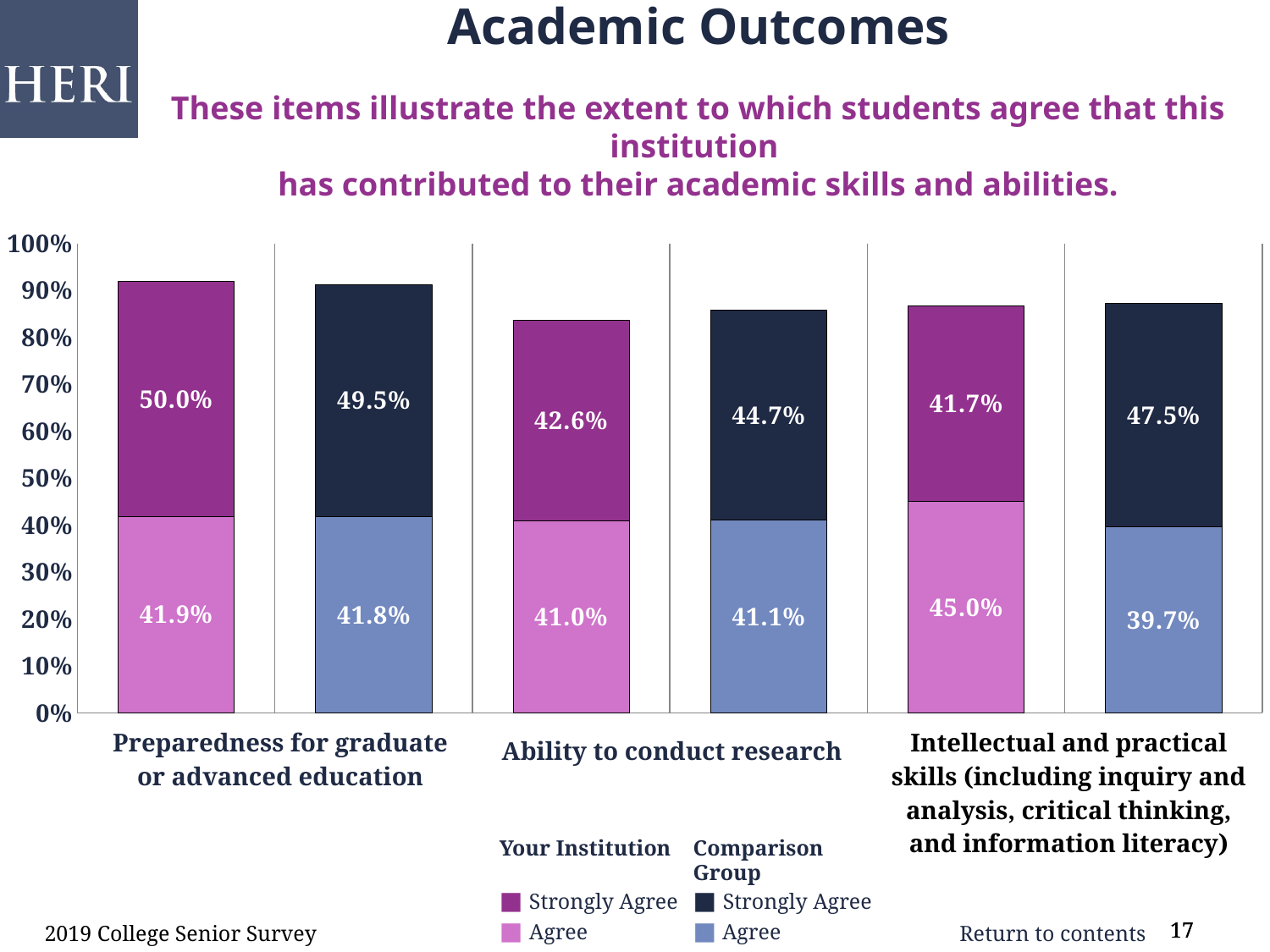
What is the Comparison Group's Strongly Agree value for Intellectual and practical skills? 47.5% For Intellectual and practical skills, which is larger: the Your Institution Agree value or the Comparison Group Agree value? Your Institution Agree (45.0%) Among the Your Institution Strongly Agree values, which category is the highest? Preparedness for graduate or advanced education What is the combined Agree and Strongly Agree total for Your Institution on Preparedness for graduate or advanced education? 91.9% What is the Your Institution Agree value for Intellectual and practical skills (including inquiry and analysis, critical thinking, and information literacy)? 45.0% What is the Comparison Group's Agree value for Ability to conduct research? 41.1% What percentage of students at Your Institution strongly agree that the institution contributed to their preparedness for graduate or advanced education? 50.0% What is the difference between the Your Institution and Comparison Group Strongly Agree values for Ability to conduct research? 2.1% How many categories are shown on the x axis of the chart? 3 Among the Comparison Group Agree values, which category is the lowest? Intellectual and practical skills (including inquiry and analysis, critical thinking, and information literacy) What type of chart is shown on the slide? Stacked bar chart What is the combined Agree and Strongly Agree total for the Comparison Group on Ability to conduct research? 85.8%